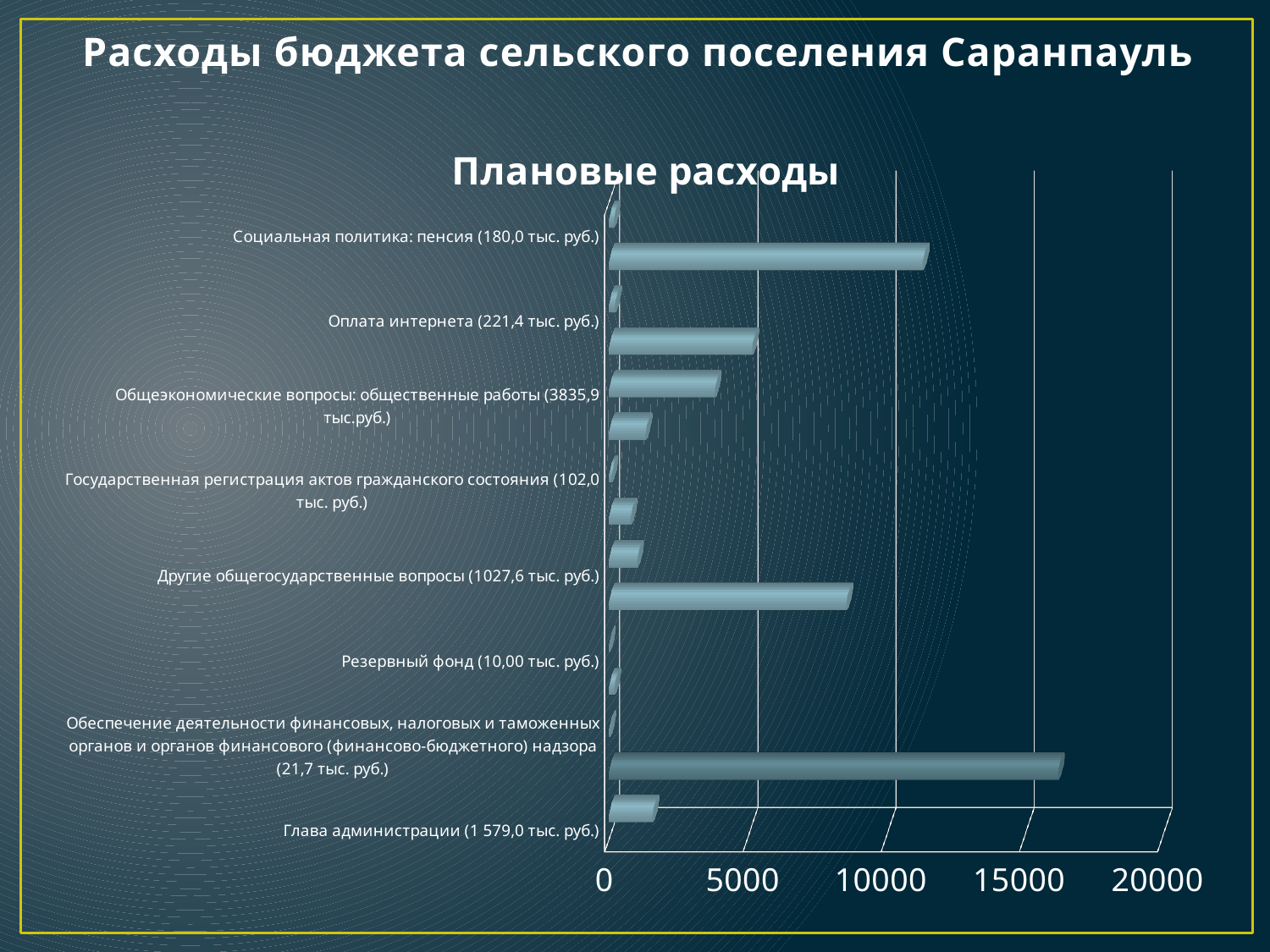
What is the highest value shown on the horizontal axis? 20000 What planned amount is given for Резервный фонд? 10,00 тыс. руб. What is the difference between the amounts for Глава администрации (1 579,0) and Другие общегосударственные вопросы (1027,6)? 551,4 тыс. руб. What kind of chart is shown on the slide? bar chart What planned amount is given for Другие общегосударственные вопросы? 1027,6 тыс. руб. Among the labelled categories, which has the smallest planned amount? Резервный фонд (10,00 тыс. руб.) What planned amount is given for Оплата интернета? 221,4 тыс. руб. What planned amount is given for Глава администрации? 1 579,0 тыс. руб. What planned amount is given for Общеэкономические вопросы: общественные работы? 3835,9 тыс.руб. Which is larger, the amount for Общеэкономические вопросы: общественные работы or for Другие общегосударственные вопросы? Общеэкономические вопросы: общественные работы Is the bar for Общеэкономические вопросы: общественные работы greater or less than 5000? less What is the title of the chart? Плановые расходы